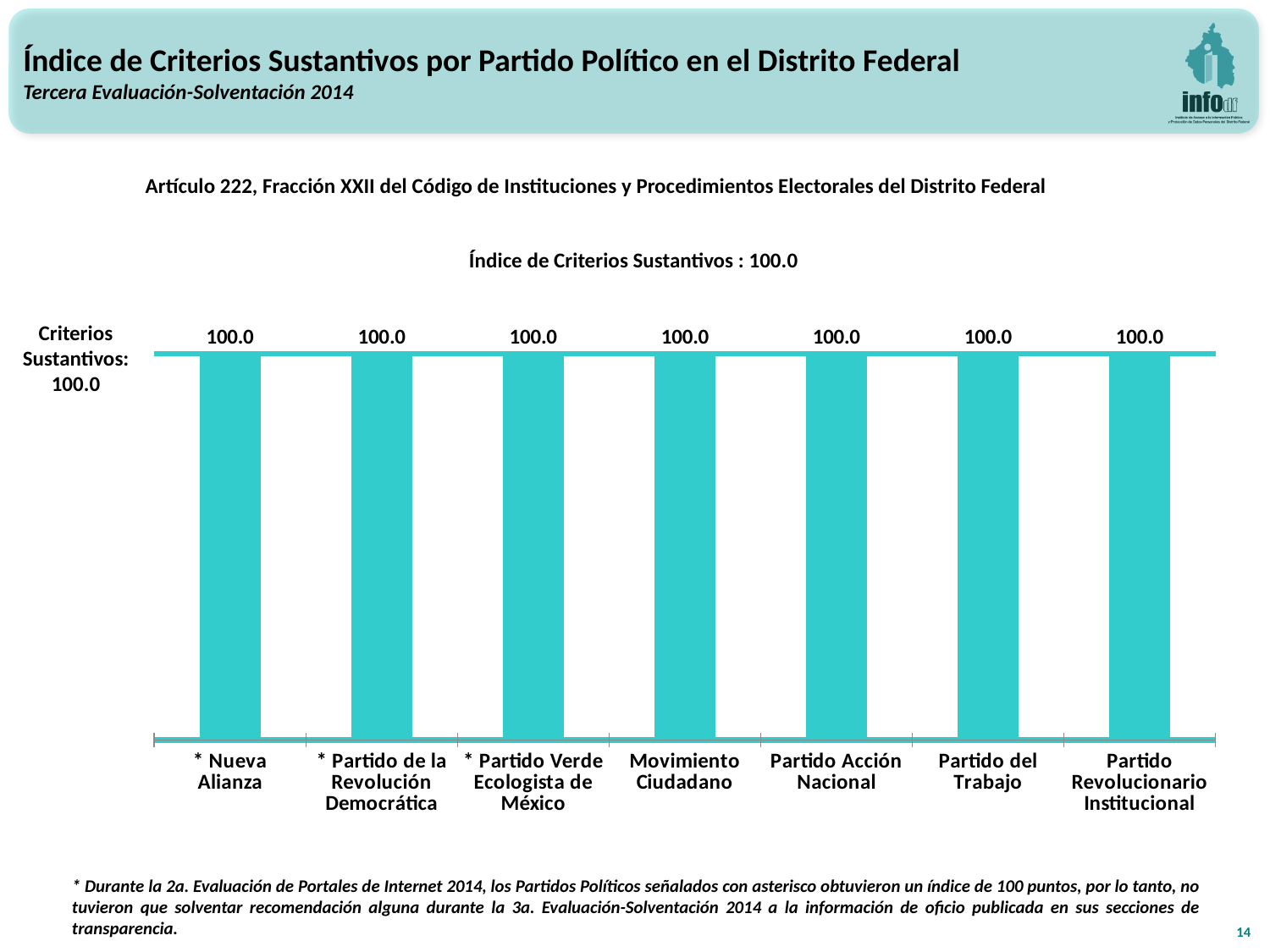
What is the difference between the values for Partido Verde Ecologista de México and Partido del Trabajo? 0.0 Do the values rise, fall, or stay the same across the parties from left to right? stay the same What is the value for Partido del Trabajo? 100.0 What is the value for Partido Acción Nacional? 100.0 What is the value for Nueva Alianza? 100.0 What is the value for Partido Revolucionario Institucional? 100.0 What kind of chart is shown on the slide? bar chart What value does the horizontal reference line labelled 'Criterios Sustantivos' represent? 100.0 How many political parties are shown in the chart? 7 Is the value for Partido de la Revolución Democrática equal to 100.0? yes What is the value for Movimiento Ciudadano? 100.0 What is the title of the chart? Índice de Criterios Sustantivos : 100.0